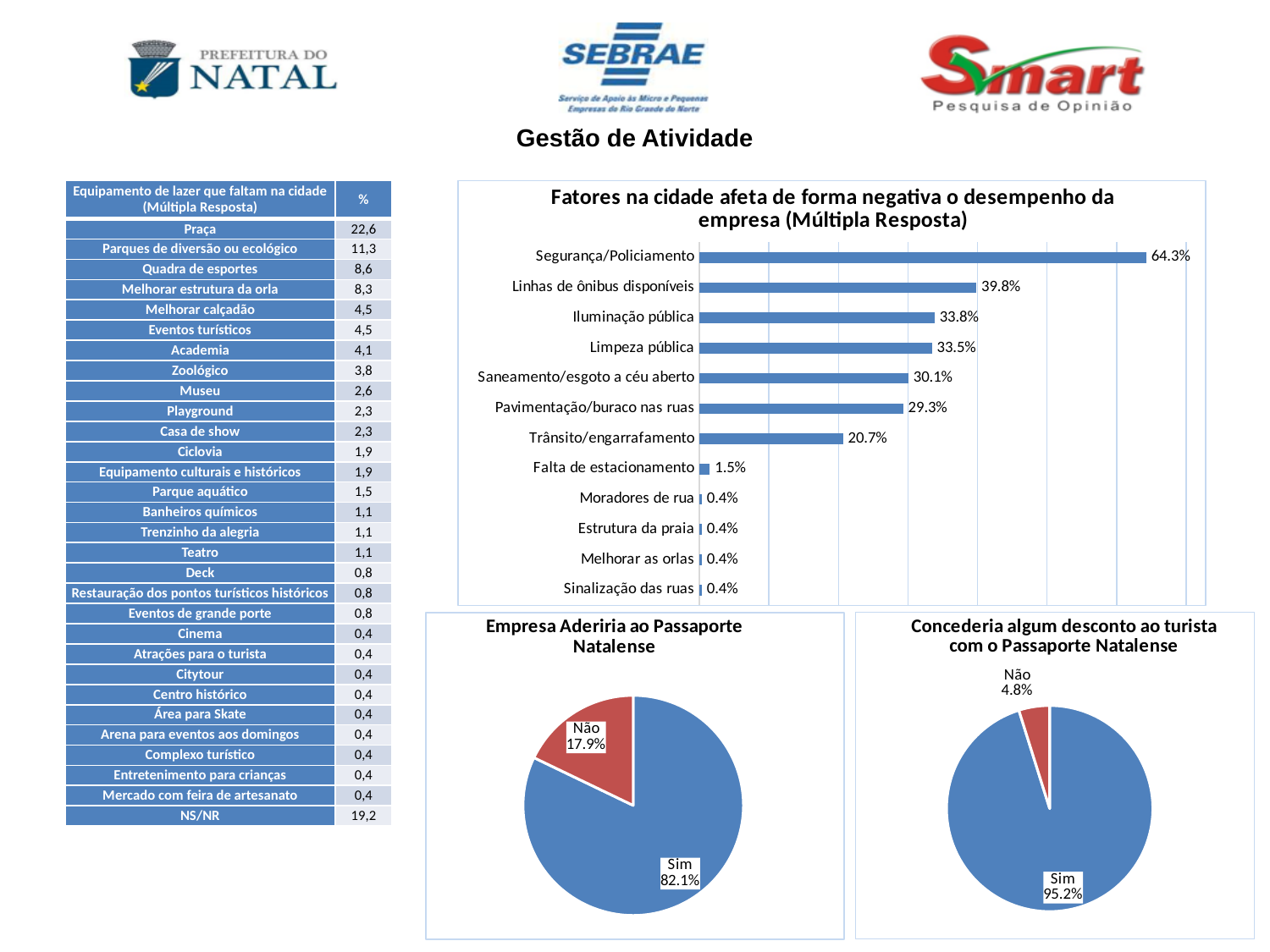
In the chart 'Fatores na cidade afeta de forma negativa o desempenho da empresa', what is the value for Falta de estacionamento? 1.5% In the chart 'Fatores na cidade afeta de forma negativa o desempenho da empresa', what is the value for Segurança/Policiamento? 64.3% What kind of chart is 'Concederia algum desconto ao turista com o Passaporte Natalense'? Pie chart How many factors are listed in the chart 'Fatores na cidade afeta de forma negativa o desempenho da empresa'? 12 In the pie chart 'Empresa Aderiria ao Passaporte Natalense', what is the value for 'Não'? 17.9% In the chart 'Fatores na cidade afeta de forma negativa o desempenho da empresa', what is the value for Saneamento/esgoto a céu aberto? 30.1% In the chart 'Fatores na cidade afeta de forma negativa o desempenho da empresa', what is the difference between Segurança/Policiamento and Linhas de ônibus disponíveis? 24.5% In the pie chart 'Empresa Aderiria ao Passaporte Natalense', what share is 'Sim'? 82.1% In the chart 'Fatores na cidade afeta de forma negativa o desempenho da empresa', which factor has the highest value? Segurança/Policiamento In the chart 'Fatores na cidade afeta de forma negativa o desempenho da empresa', which is larger: Pavimentação/buraco nas ruas or Trânsito/engarrafamento? Pavimentação/buraco nas ruas In the pie chart 'Concederia algum desconto ao turista com o Passaporte Natalense', what share is 'Não'? 4.8% What kind of chart is 'Fatores na cidade afeta de forma negativa o desempenho da empresa'? Bar chart